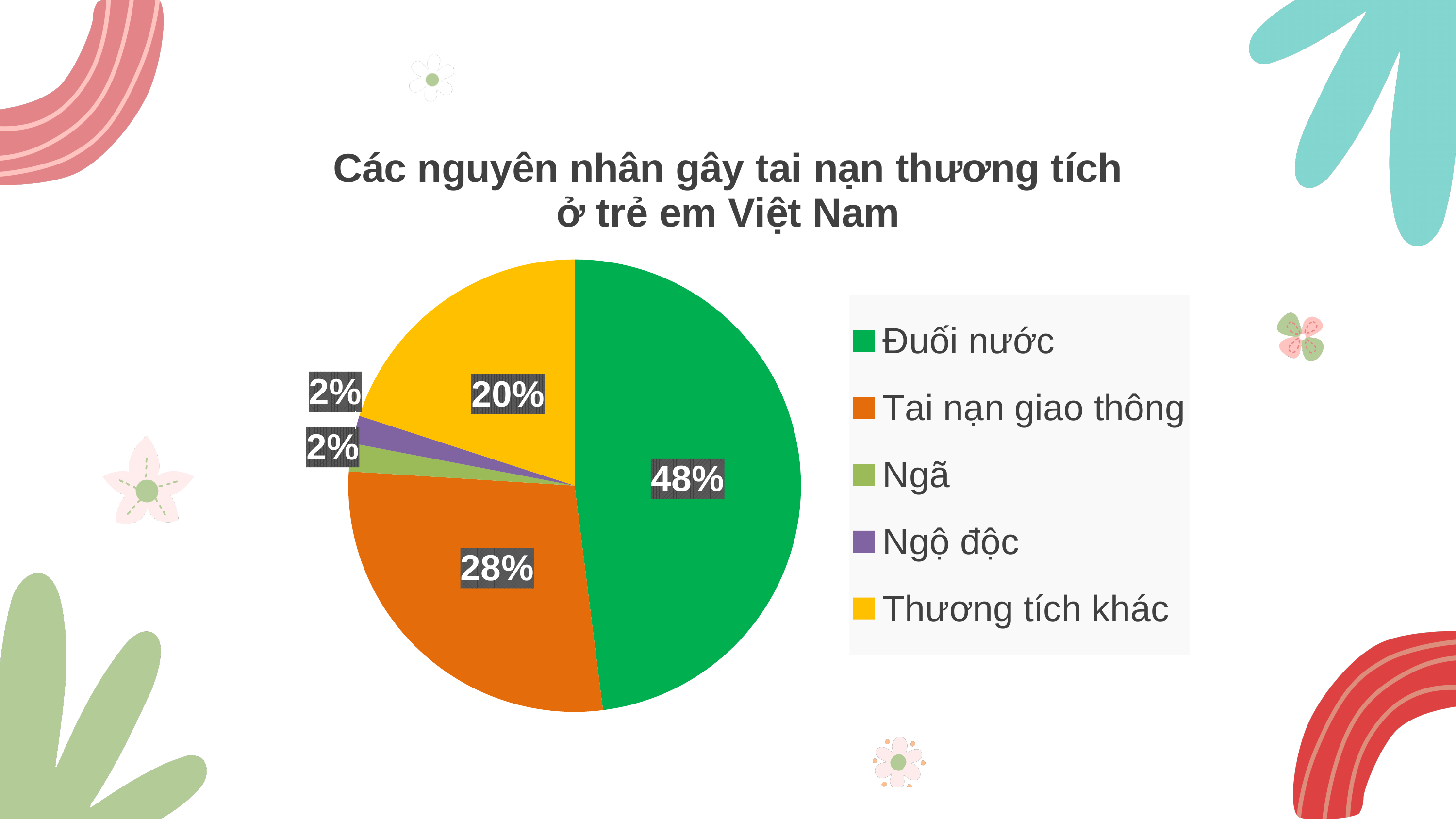
What kind of chart is shown on the slide? pie chart What percentage is shown for Ngộ độc? 2% What percentage is shown for Ngã? 2% What is the difference in percentage points between Đuối nước and Tai nạn giao thông? 20 What is the title of the chart? Các nguyên nhân gây tai nạn thương tích ở trẻ em Việt Nam How many categories does the legend list? 5 What percentage is shown for Thương tích khác? 20% Which category has the largest slice of the pie? Đuối nước Which is larger, the slice for Tai nạn giao thông or the slice for Thương tích khác? Tai nạn giao thông What share of the pie does Đuối nước account for? 48% What percentage is shown for Tai nạn giao thông? 28% What colour is the slice for Thương tích khác? yellow